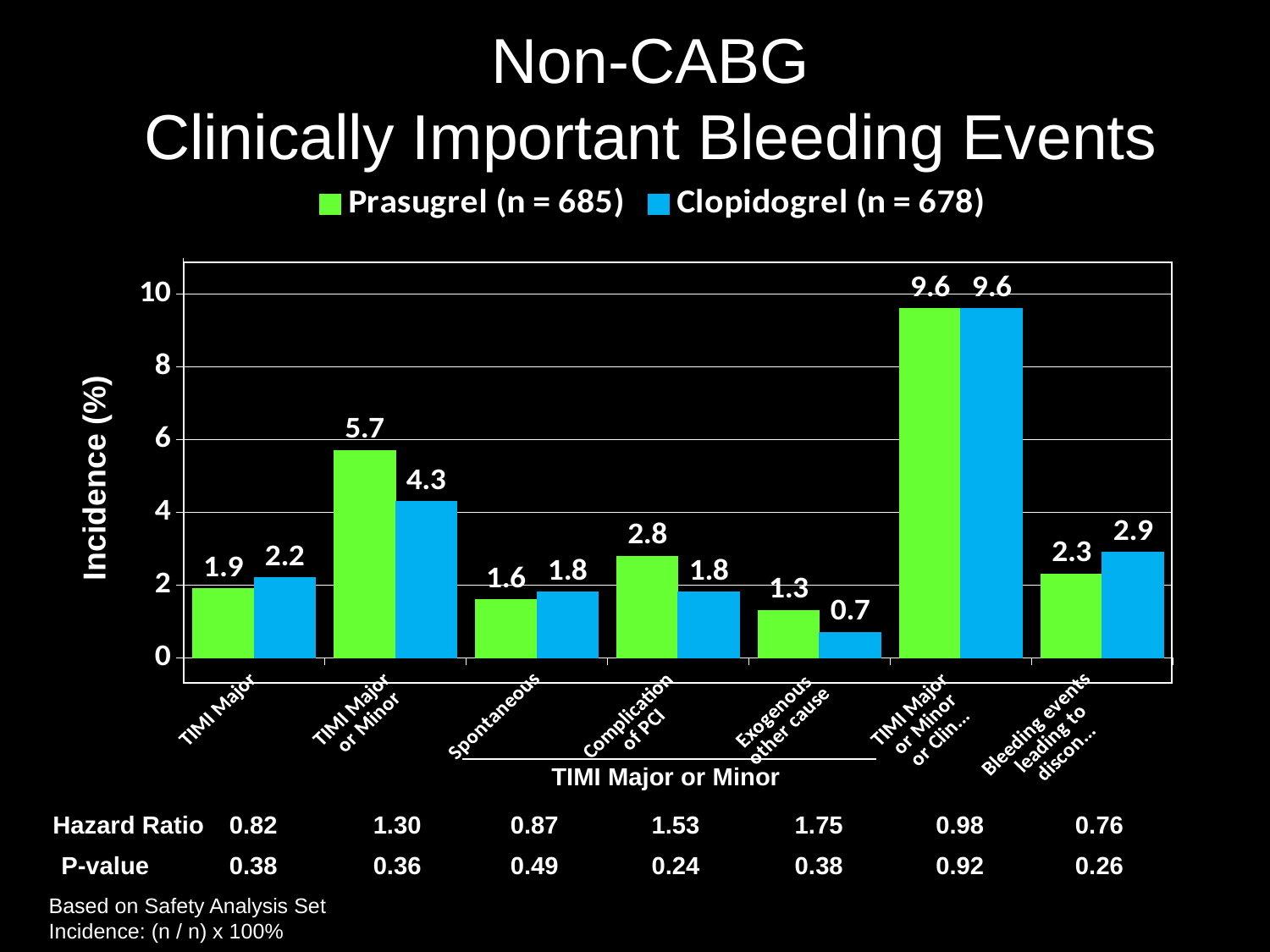
What kind of chart is shown on the slide? Bar chart How many categories are shown on the x axis? 7 What is the Clopidogrel value for Exogenous other cause? 0.7 What is the Prasugrel value for Complication of PCI? 2.8 For Spontaneous, which series has the larger value, Prasugrel or Clopidogrel? Clopidogrel What is the label of the y axis? Incidence (%) Which category has the highest Prasugrel value? TIMI Major or Minor or Clin... What is the Prasugrel value for TIMI Major? 1.9 Which category has the lowest Clopidogrel value? Exogenous other cause What is the difference between the Prasugrel and Clopidogrel values for TIMI Major or Minor? 1.4 How many series does the legend list? 2 What is the Clopidogrel value for TIMI Major or Minor? 4.3